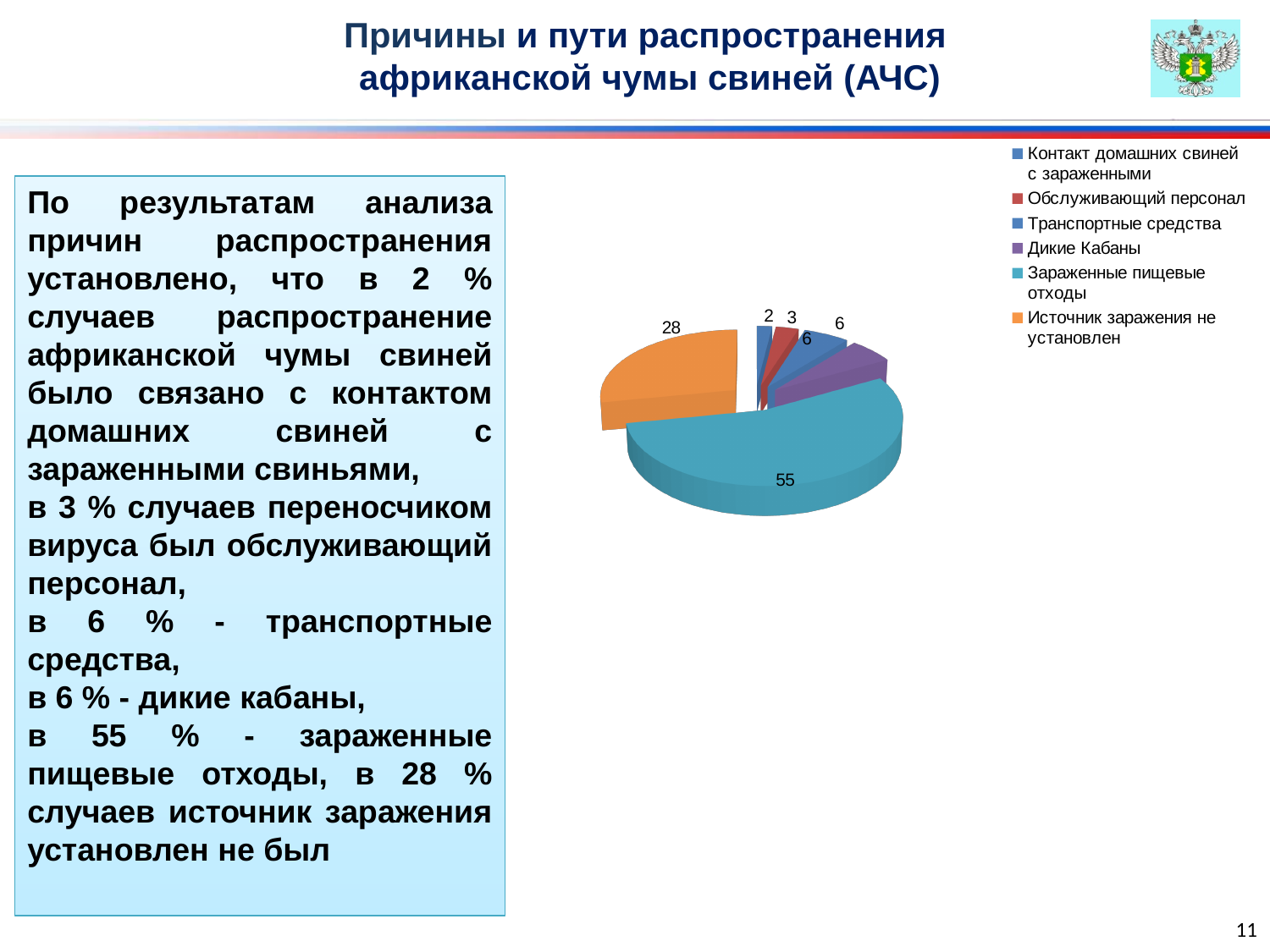
What is the value for "Обслуживающий персонал" in the pie chart? 3 Which category has the smallest slice in the pie chart? Контакт домашних свиней с зараженными What is the difference between the values for "Зараженные пищевые отходы" and "Источник заражения не установлен"? 27 What is the value for "Зараженные пищевые отходы" in the pie chart? 55 What type of chart is shown on the slide? Pie chart What colour is the slice for "Источник заражения не установлен" in the pie chart? Orange How many categories are shown in the pie chart? 6 What is the value for "Источник заражения не установлен" in the pie chart? 28 What share of the pie does "Зараженные пищевые отходы" represent? 55% What is the value for "Контакт домашних свиней с зараженными" in the pie chart? 2 Which is larger: the value for "Источник заражения не установлен" or the value for "Транспортные средства"? Источник заражения не установлен Which category has the largest slice in the pie chart? Зараженные пищевые отходы